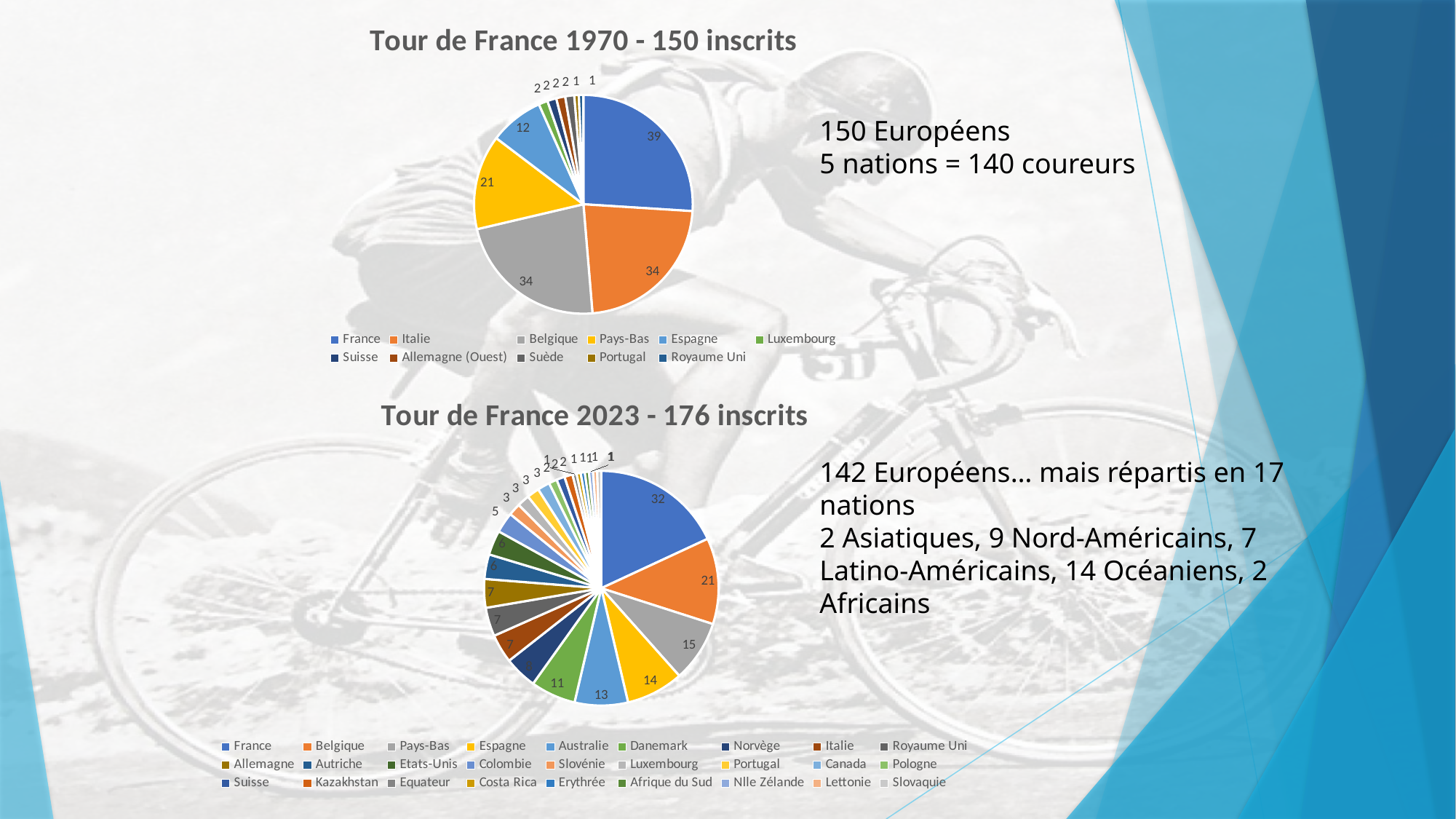
In the 'Tour de France 2023 - 176 inscrits' chart, what is the value for Belgique? 21 What type of chart is 'Tour de France 2023 - 176 inscrits'? Pie chart In the 'Tour de France 1970 - 150 inscrits' chart, how many entries does the legend list? 11 In the 'Tour de France 1970 - 150 inscrits' chart, which country has the largest slice? France In the 'Tour de France 2023 - 176 inscrits' chart, what is the value for Espagne? 14 In the 'Tour de France 2023 - 176 inscrits' chart, which is larger, the value for Pays-Bas or the value for Australie? Pays-Bas In the 'Tour de France 1970 - 150 inscrits' chart, what is the value for Pays-Bas? 21 In the 'Tour de France 2023 - 176 inscrits' chart, what is the value for France? 32 In the 'Tour de France 1970 - 150 inscrits' chart, what is the value for Espagne? 12 In the 'Tour de France 2023 - 176 inscrits' chart, what is the difference between the values for France and Belgique? 11 In the 'Tour de France 1970 - 150 inscrits' chart, what is the difference between the values for France and Pays-Bas? 18 In the 'Tour de France 1970 - 150 inscrits' chart, what is the value for France? 39